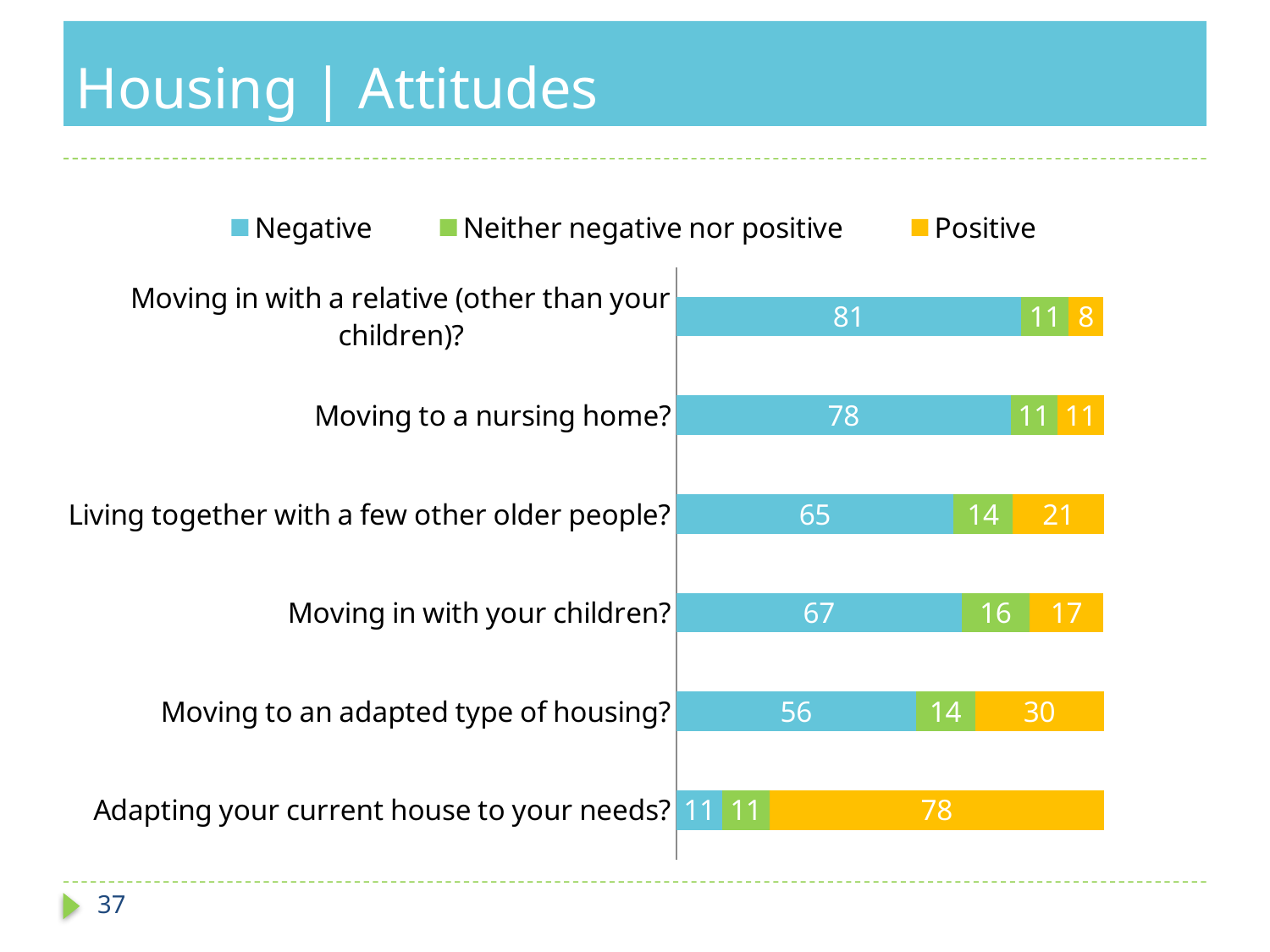
Which category has the highest Negative value? Moving in with a relative (other than your children)? What is the difference between the Negative values for "Moving in with a relative (other than your children)?" and "Moving to an adapted type of housing?"? 25 What is the "Neither negative nor positive" value for "Moving in with your children?"? 16 What is the Negative value for "Moving to a nursing home?"? 78 Which category has the highest Positive value? Adapting your current house to your needs? How many series does the legend list? 3 What is the Positive value for "Moving to an adapted type of housing?"? 30 What kind of chart is shown on the slide? Stacked bar chart Which category has the lowest Negative value? Adapting your current house to your needs? What is the total of the stacked bar for "Moving to an adapted type of housing?"? 100 How many categories are shown on the chart? 6